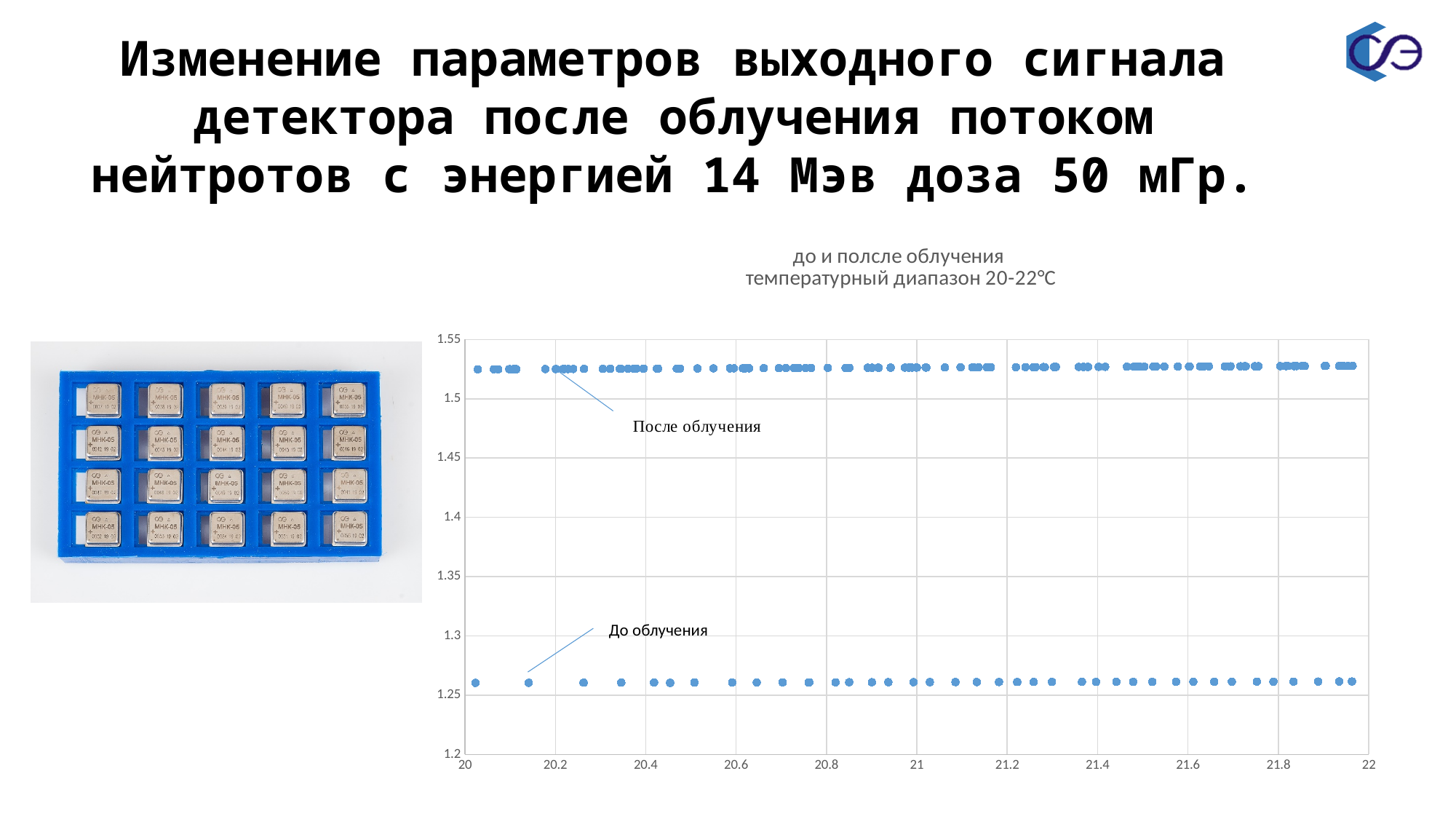
Do the "До облучения" values rise, fall, or stay roughly flat as the x value increases from 20 to 22? stay roughly flat Are the values for "После облучения" greater or less than 1.5? greater Are the values for "До облучения" greater or less than 1.3? less What is the lowest value shown on the y axis of the chart? 1.2 Do the "После облучения" values rise, fall, or stay roughly flat along the x axis? stay roughly flat How many groups of points are labelled on the chart? 2 What is the title of the chart? до и полсле облучения температурный диапазон 20-22℃ What kind of chart is shown on the slide? scatter chart Are the values for "До облучения" greater or less than 1.25? greater What is the highest value shown on the x axis of the chart? 22 Which group of points has the higher values, "После облучения" or "До облучения"? После облучения